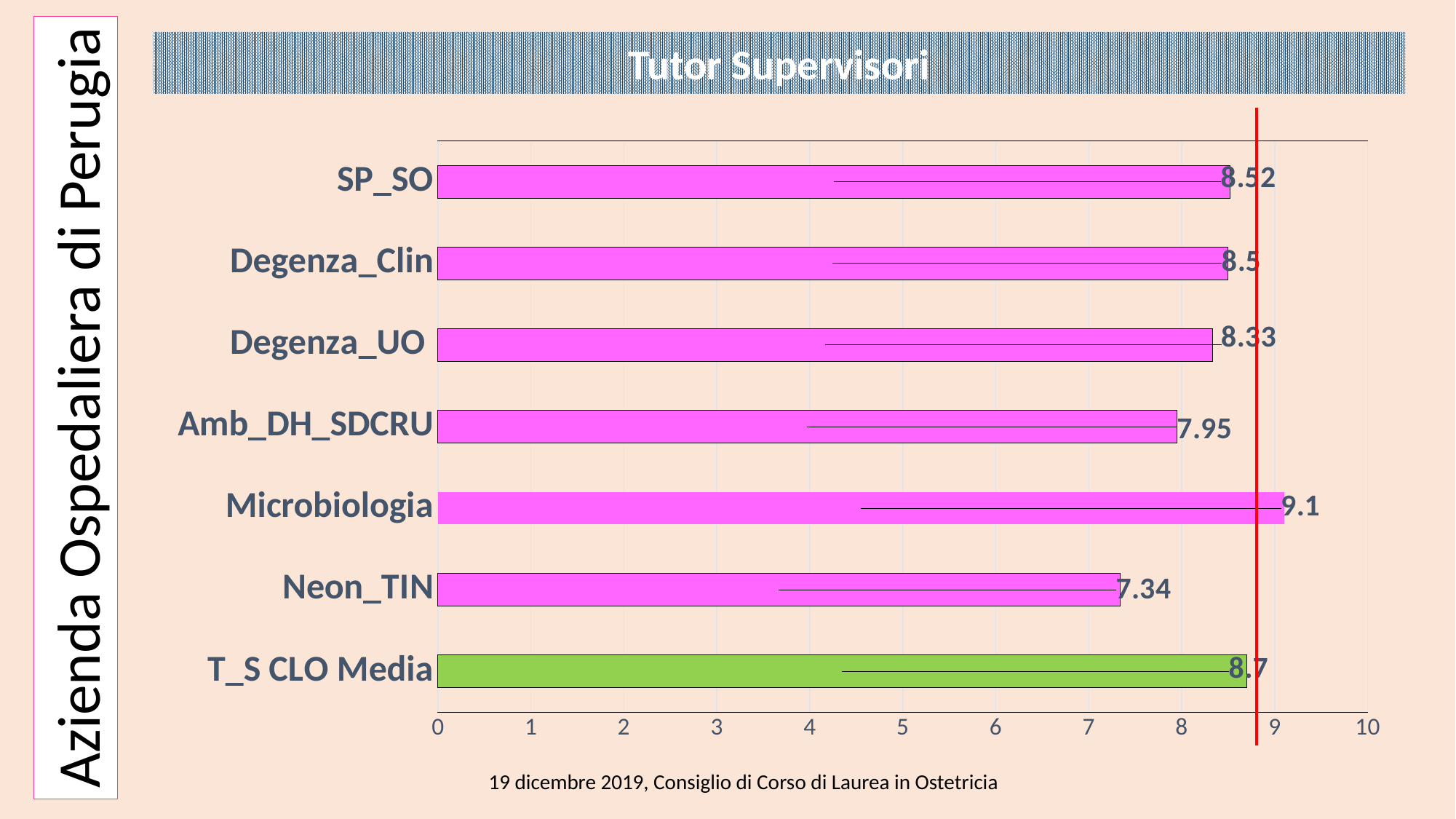
What is the value for Microbiologia? 9.1 Which category has the highest value? Microbiologia What is the value for SP_SO? 8.52 What is the difference between the values for Microbiologia and Neon_TIN? 1.76 What kind of chart is shown on the slide? Bar chart What is the value for Neon_TIN? 7.34 What is the title of the chart? Tutor Supervisori Is the value for Amb_DH_SDCRU greater or less than 8? less What is the value for T_S CLO Media? 8.7 How many categories are shown in the chart? 7 Which category has the lowest value? Neon_TIN Which is larger, the value for Degenza_UO or the value for Amb_DH_SDCRU? Degenza_UO